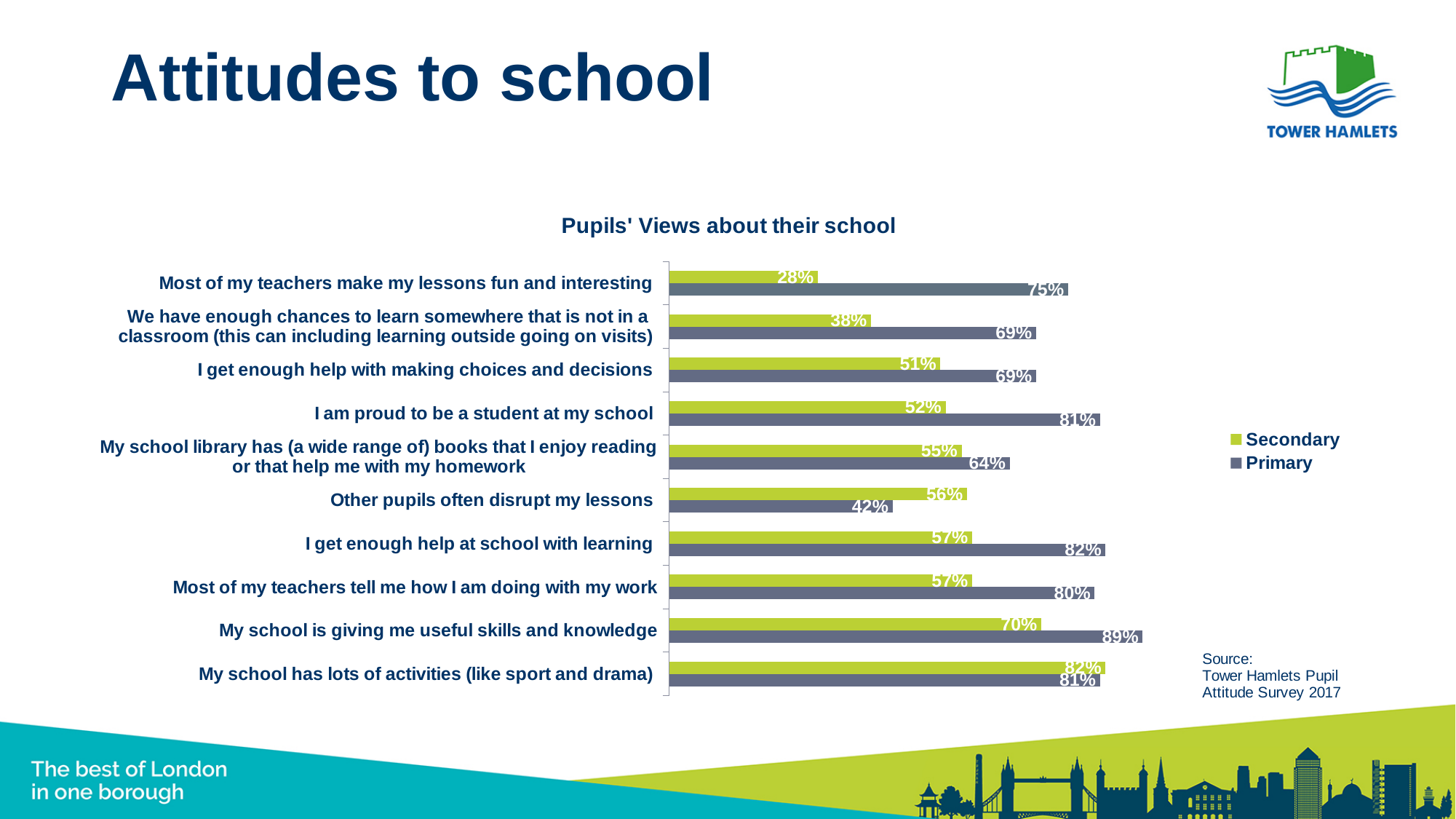
Which statement has the highest Primary value? My school is giving me useful skills and knowledge What is the title of the chart? Pupils' Views about their school Which statement has the lowest Secondary value? Most of my teachers make my lessons fun and interesting For "Other pupils often disrupt my lessons", which is larger, the Secondary or the Primary value? Secondary What is the Primary value for "Other pupils often disrupt my lessons"? 42% Which colour represents the Secondary series? Green What is the Primary value for "I am proud to be a student at my school"? 81% How many series does the legend list? 2 What kind of chart is shown? Bar chart How many statements are listed on the chart? 10 What is the Secondary value for "Most of my teachers make my lessons fun and interesting"? 28% What is the difference between the Primary and Secondary values for "Most of my teachers make my lessons fun and interesting"? 47%